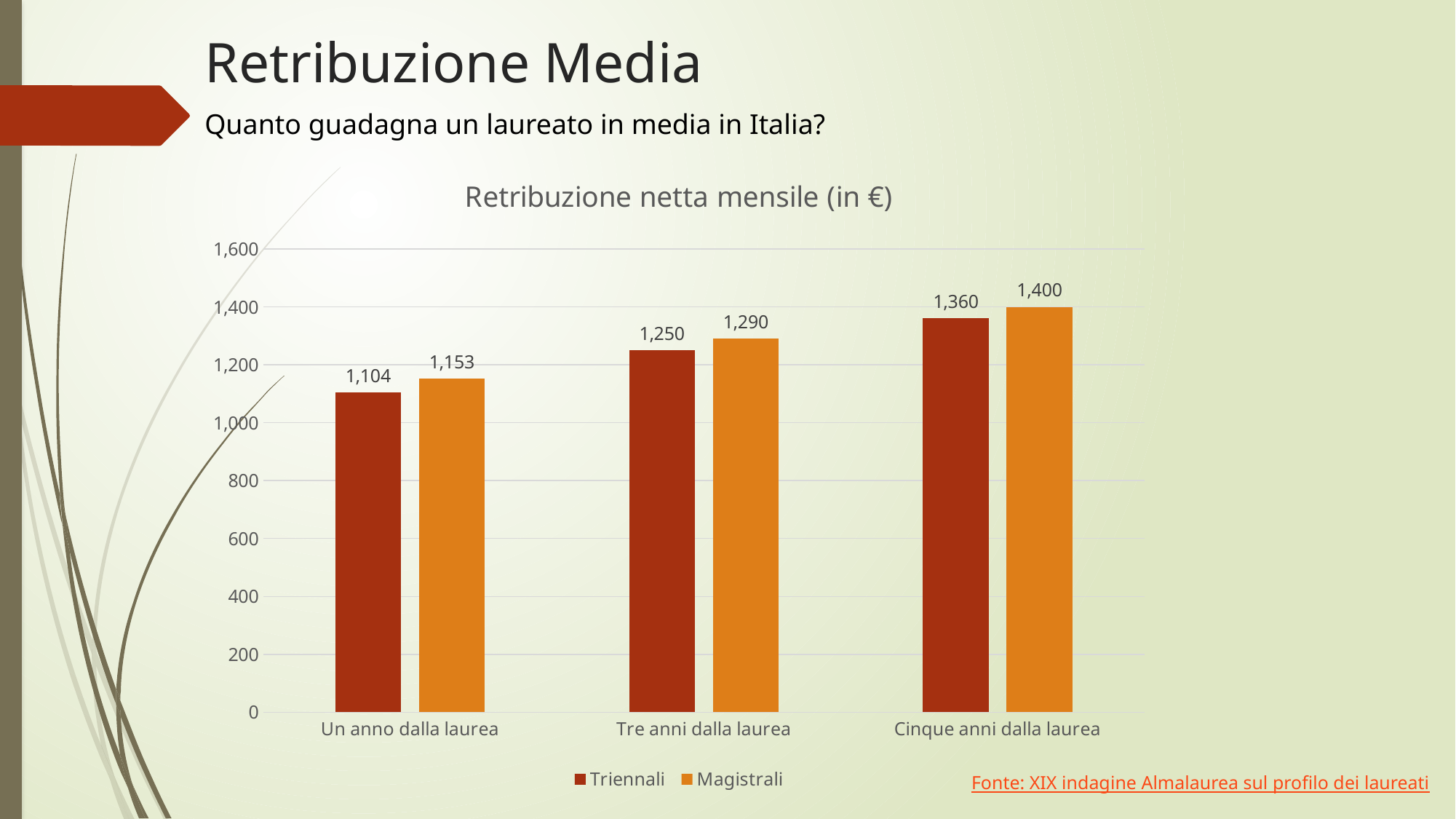
Which category has the lowest value for Magistrali? Un anno dalla laurea What is the value for Magistrali at 'Cinque anni dalla laurea'? 1,400 What kind of chart is shown on the slide? Bar chart Do the Magistrali values rise or fall from 'Un anno dalla laurea' to 'Cinque anni dalla laurea'? Rise How many series does the legend list? 2 What is the value for Triennali at 'Un anno dalla laurea'? 1,104 What is the value for Magistrali at 'Tre anni dalla laurea'? 1,290 Which is larger at 'Tre anni dalla laurea': Triennali or Magistrali? Magistrali Which category has the highest value for Triennali? Cinque anni dalla laurea What is the difference between the Triennali values at 'Cinque anni dalla laurea' and 'Tre anni dalla laurea'? 110 How many categories are shown on the x axis? 3 What is the difference between Magistrali and Triennali at 'Un anno dalla laurea'? 49